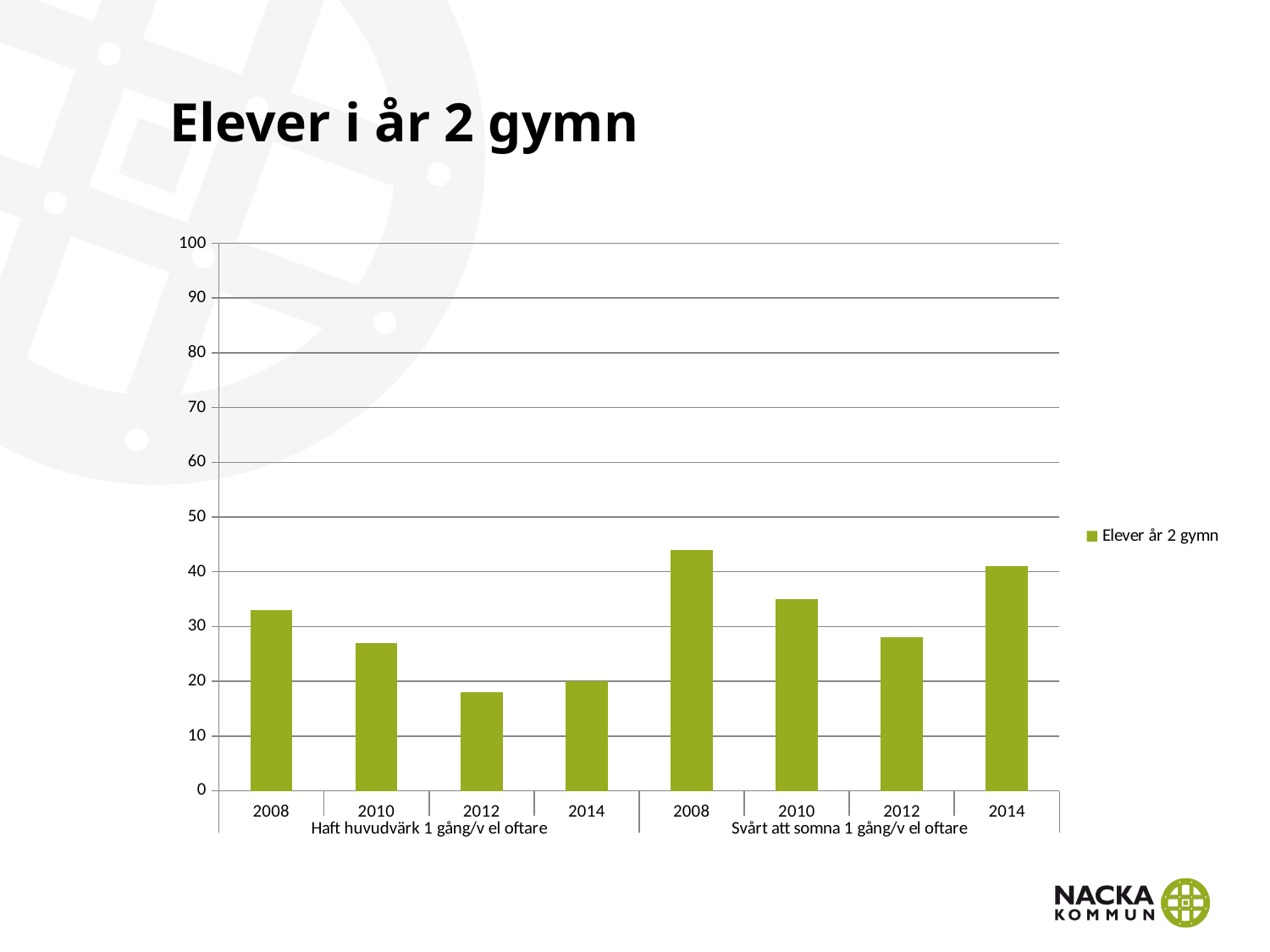
Which year has the highest value in the 'Haft huvudvärk 1 gång/v el oftare' group? 2008 Is the value for 2012 in the 'Haft huvudvärk 1 gång/v el oftare' group greater or less than 20? less For 2010, which group has the larger value: 'Haft huvudvärk 1 gång/v el oftare' or 'Svårt att somna 1 gång/v el oftare'? Svårt att somna 1 gång/v el oftare In the 'Haft huvudvärk 1 gång/v el oftare' group, do the values rise or fall from 2008 to 2012? fall How many series does the legend list? 1 What is the legend entry for the series in the chart? Elever år 2 gymn How many bars are plotted in the chart? 8 Is the value for 2008 in the 'Haft huvudvärk 1 gång/v el oftare' group greater or less than 30? greater Is the value for 2012 in the 'Svårt att somna 1 gång/v el oftare' group greater or less than 30? less What kind of chart is shown on the slide? bar chart Which year has the lowest value in the 'Svårt att somna 1 gång/v el oftare' group? 2012